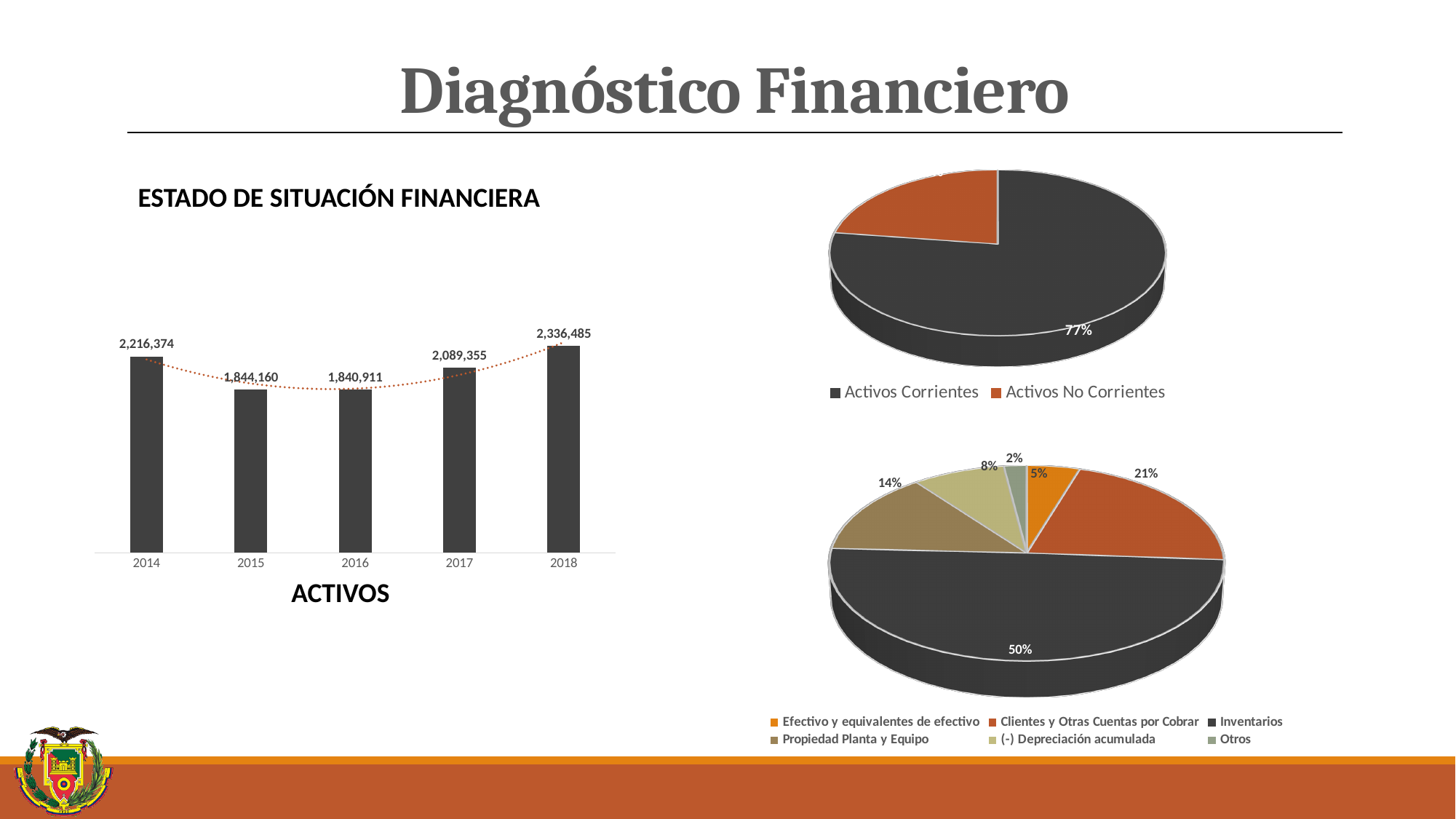
In the bar chart titled ESTADO DE SITUACIÓN FINANCIERA, what is the value for 2016? 1,840,911 What kind of chart is the chart titled ESTADO DE SITUACIÓN FINANCIERA? bar chart In the bar chart titled ESTADO DE SITUACIÓN FINANCIERA, what is the difference between the 2018 value and the 2017 value? 247,130 In the bar chart titled ESTADO DE SITUACIÓN FINANCIERA, how many years are shown on the x axis? 5 In the bar chart titled ESTADO DE SITUACIÓN FINANCIERA, what is the value for 2014? 2,216,374 In the bottom-right pie chart, which category has the smallest share? Otros In the bar chart titled ESTADO DE SITUACIÓN FINANCIERA, which year has the highest value? 2018 In the bottom-right pie chart, what share is labelled for Inventarios? 50% In the bar chart titled ESTADO DE SITUACIÓN FINANCIERA, do the values rise or fall from 2016 to 2018? rise In the bar chart titled ESTADO DE SITUACIÓN FINANCIERA, which year has the lowest value? 2016 In the top-right pie chart, what share is labelled for Activos Corrientes? 77% How many series does the legend of the top-right pie chart list? 2